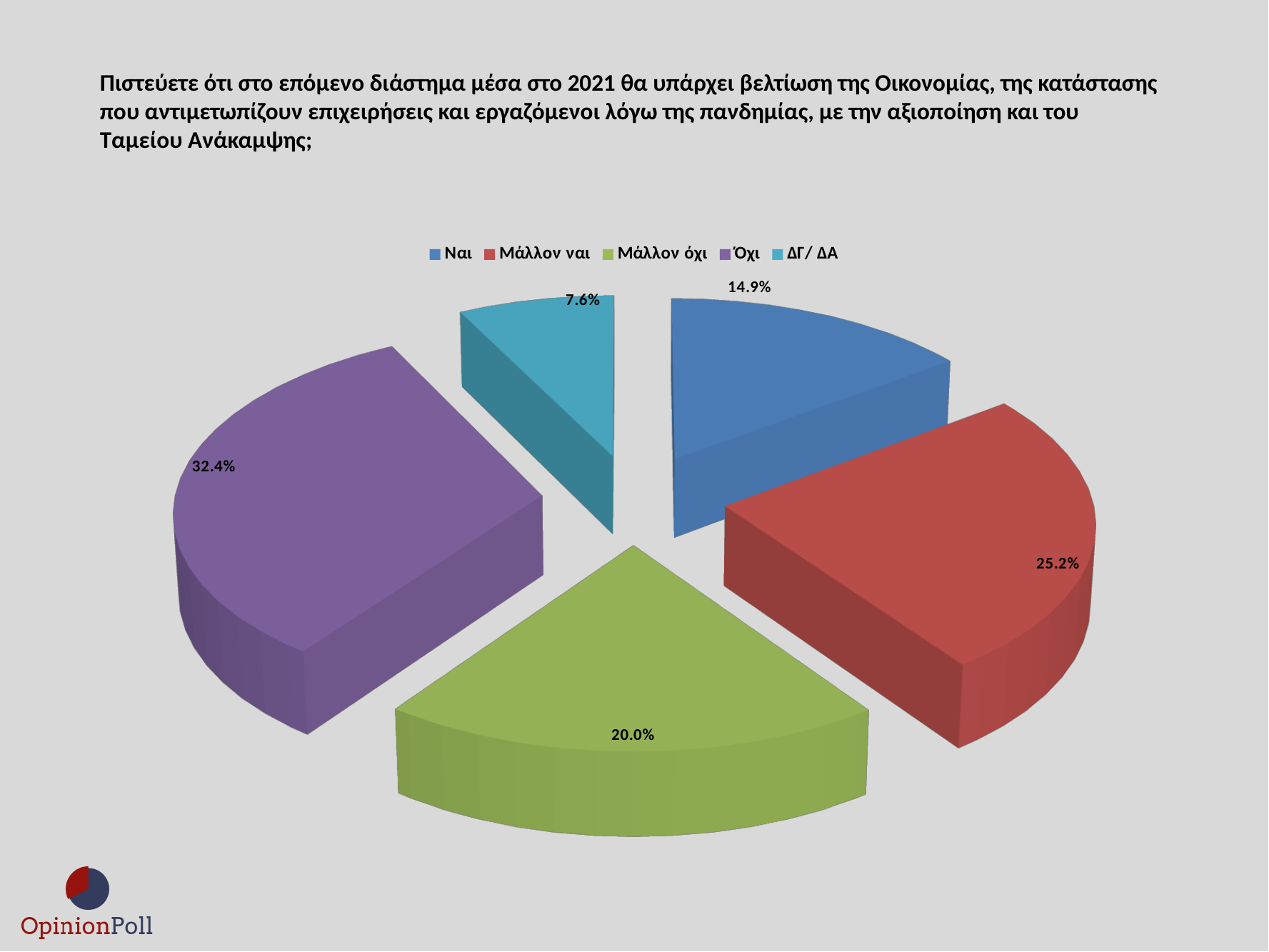
Which response has the smallest share of the pie? ΔΓ/ ΔΑ Which response has the largest share of the pie? Όχι What kind of chart is shown on the slide? Pie chart Which is larger, the share for "Μάλλον ναι" or the share for "Μάλλον όχι"? Μάλλον ναι What percentage of respondents answered "Μάλλον όχι"? 20.0% What is the difference in percentage points between "Όχι" and "Ναι"? 17.5 What percentage of respondents answered "ΔΓ/ ΔΑ"? 7.6% What percentage of respondents answered "Όχι"? 32.4% What percentage of respondents answered "Μάλλον ναι"? 25.2% What percentage of respondents answered "Ναι"? 14.9% What colour is the slice for "Όχι"? Purple How many slices does the pie chart have? 5